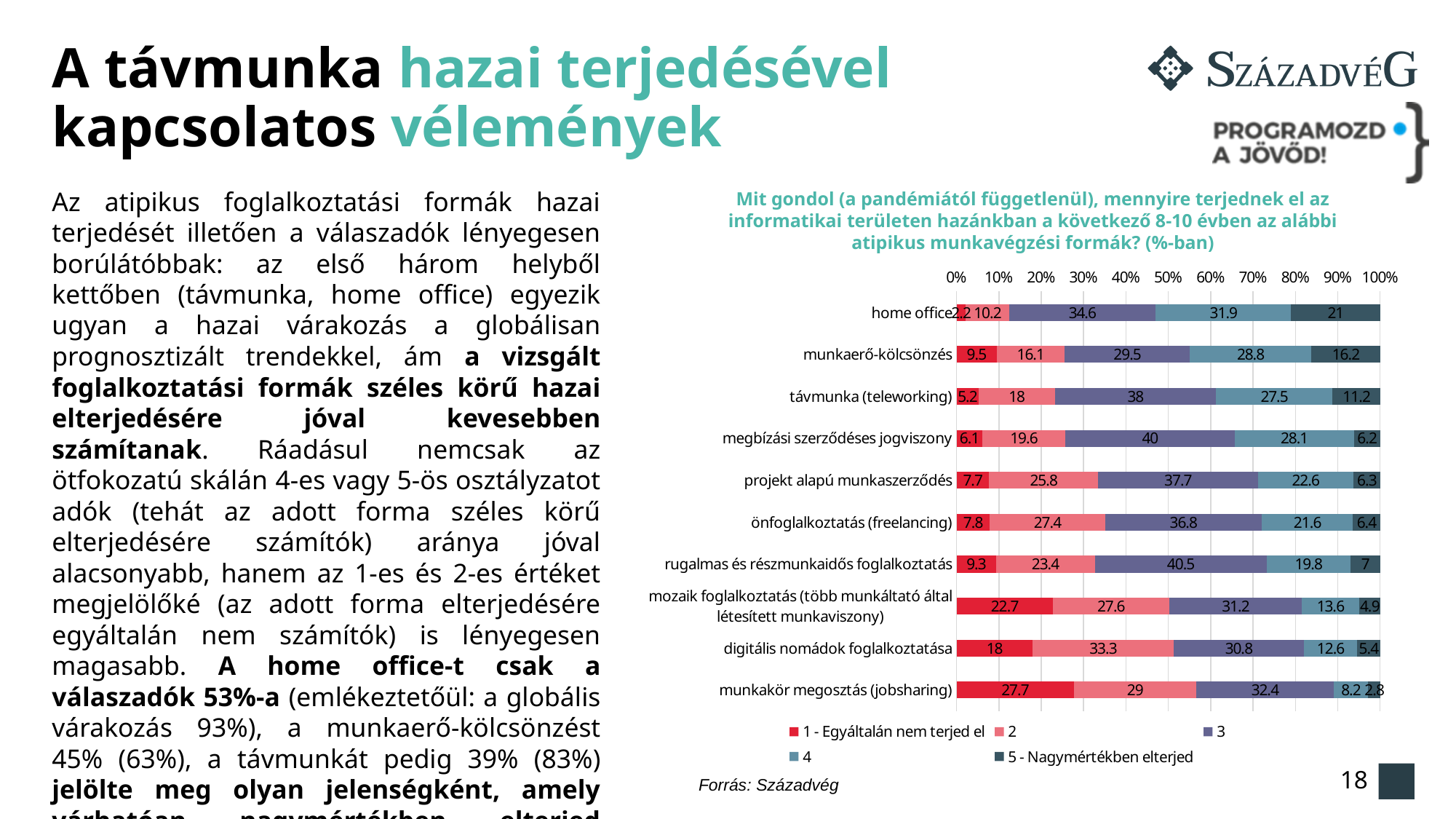
What type of chart is shown on the slide? stacked bar chart Which category has the highest value in the '5 - Nagymértékben elterjed' series? home office How many atypical work forms (categories) are plotted in the chart? 10 What is the difference between the '4' series values for home office (31.9) and munkaerő-kölcsönzés (28.8)? 3.1 How many series does the chart legend list? 5 What is the label of the first legend entry in the chart? 1 - Egyáltalán nem terjed el What is the value of the '1 - Egyáltalán nem terjed el' series for munkakör megosztás (jobsharing)? 27.7 What is the value of the '3' series for távmunka (teleworking)? 38 What is the value of the '5 - Nagymértékben elterjed' series for home office? 21 What is the total of the stacked bar for home office (2.2 + 10.2 + 34.6 + 31.9 + 21)? 99.9 Which category has the lowest value in the '1 - Egyáltalán nem terjed el' series? home office Which is larger: the '2' series value for digitális nomádok foglalkoztatása or for mozaik foglalkoztatás? digitális nomádok foglalkoztatása